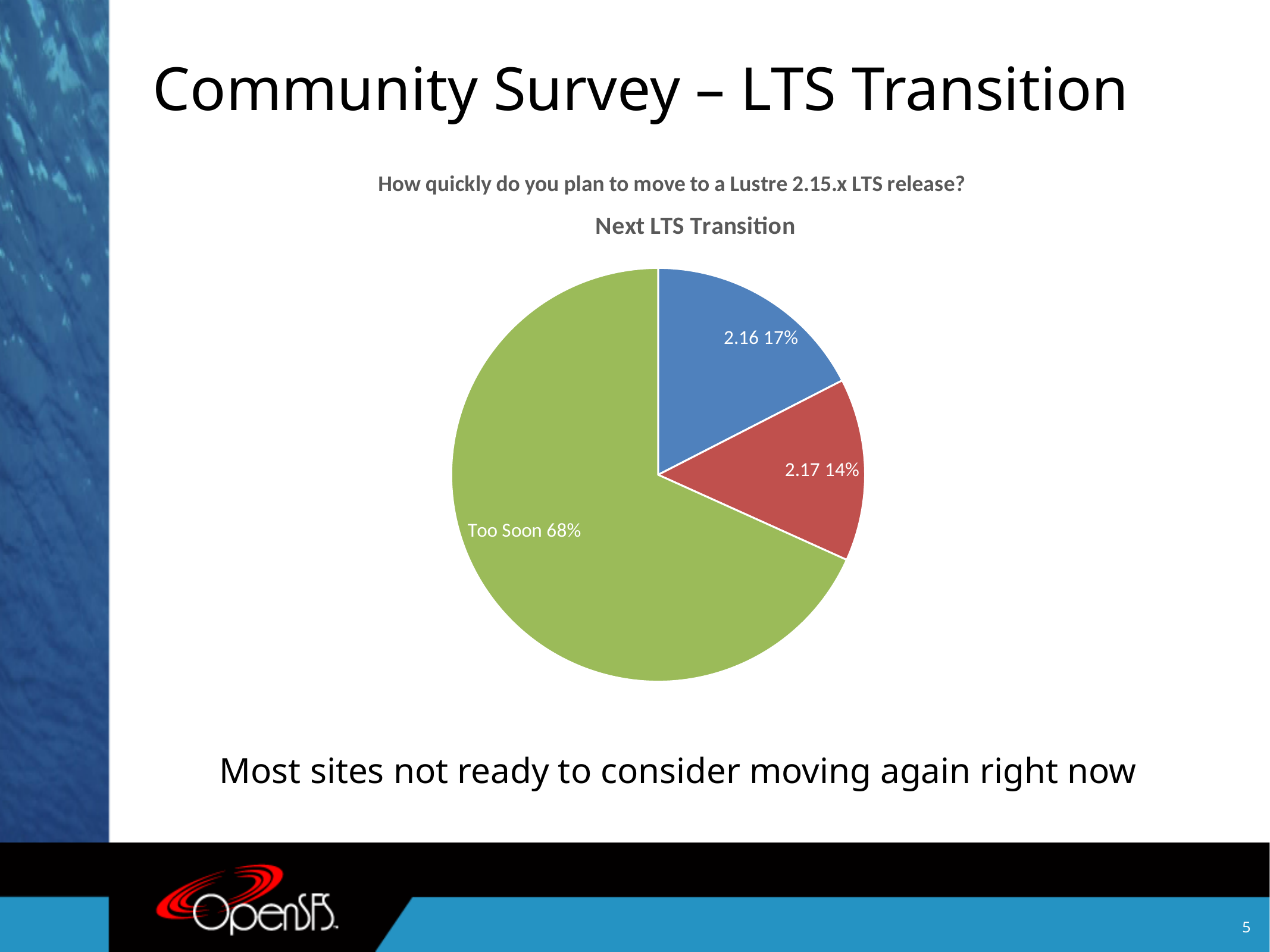
What share of the pie does the "2.16" slice represent? 17% What colour is the "Too Soon" slice? green How many slices does the pie chart have? 3 What share of the pie does the "2.17" slice represent? 14% What is the difference in percentage points between the "2.16" slice and the "2.17" slice? 3 What kind of chart is shown on the slide? pie chart What is the title of the chart? Next LTS Transition Which slice of the pie is the smallest? 2.17 What is the difference in percentage points between the "Too Soon" slice and the "2.16" slice? 51 Which slice is larger, "2.16" or "2.17"? 2.16 What share of the pie does the "Too Soon" slice represent? 68% Which slice of the pie is the largest? Too Soon